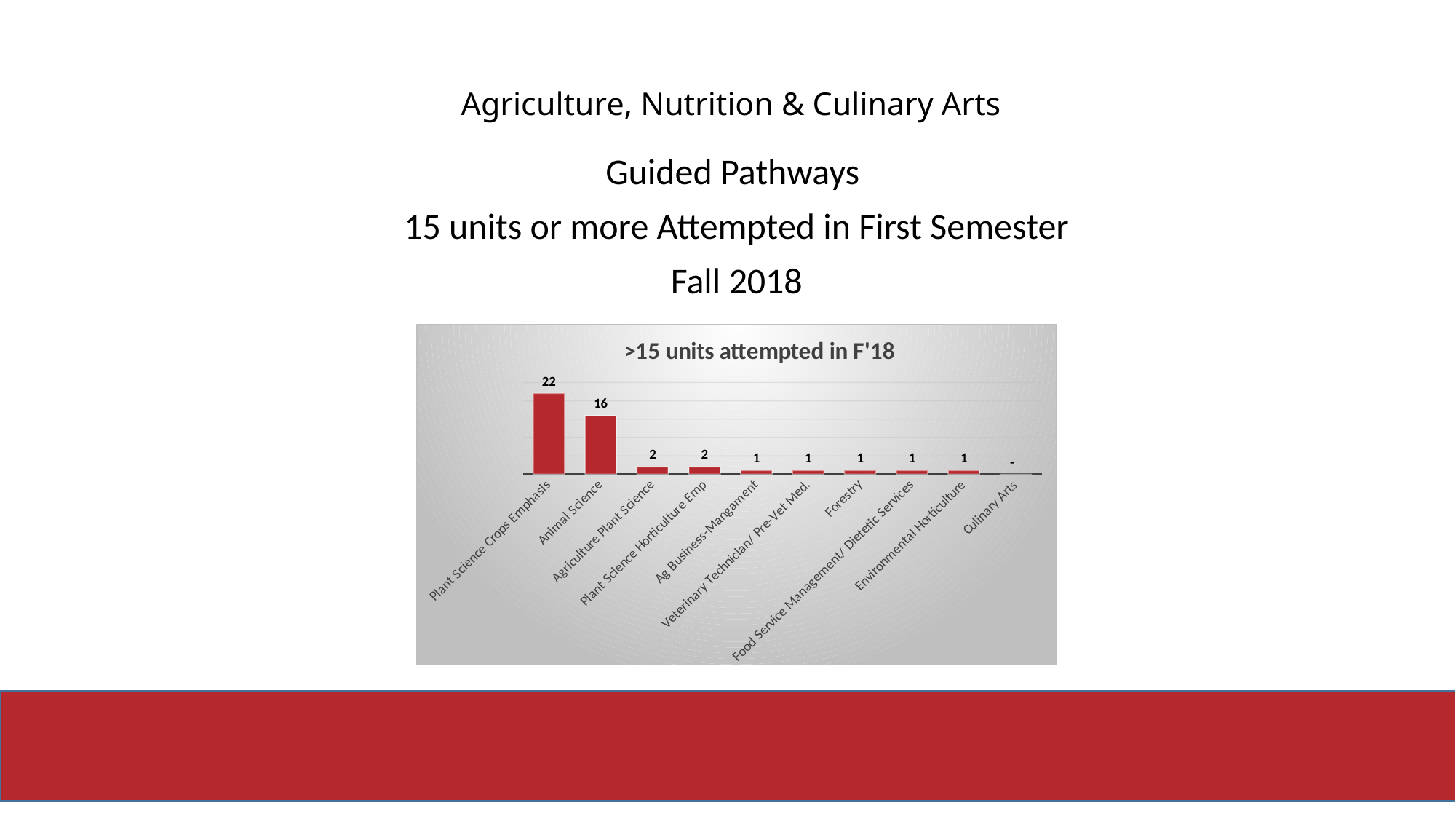
What is the value for Animal Science? 16 What kind of chart is shown? Bar chart What is the value for Plant Science Crops Emphasis? 22 What is the difference between the values for Plant Science Crops Emphasis and Animal Science? 6 What colour are the bars in the chart? Red Do the values rise or fall from left to right along the x axis? Fall Which is larger, the value for Animal Science or the value for Plant Science Horticulture Emp? Animal Science Which category has the highest value? Plant Science Crops Emphasis What is the value for Agriculture Plant Science? 2 What is the value for Forestry? 1 What is the title of the chart? >15 units attempted in F'18 How many categories are shown on the x axis? 10